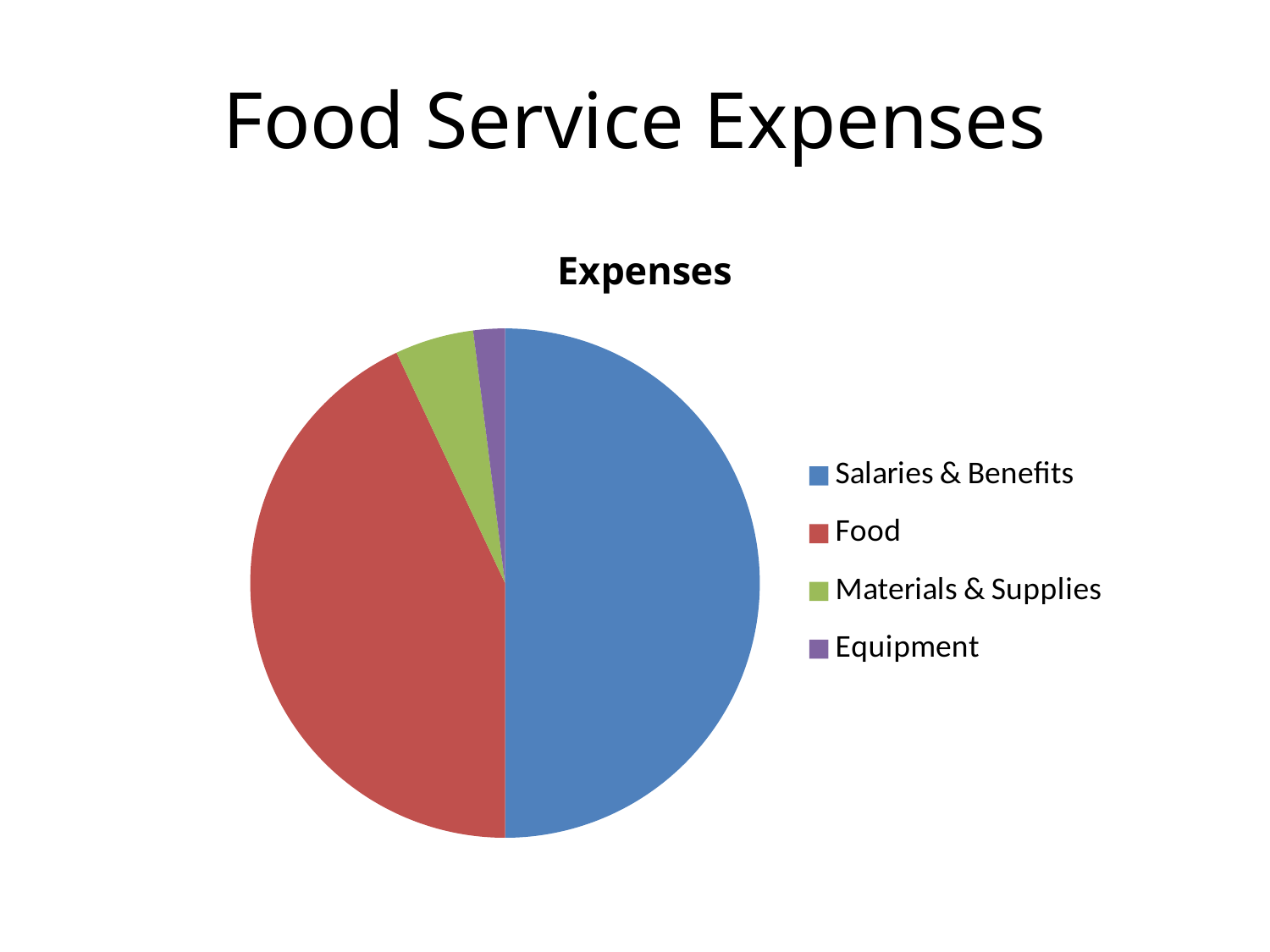
Which slice is larger, Food or Materials & Supplies? Food How many entries does the legend list? 4 Which slice is larger, Materials & Supplies or Equipment? Materials & Supplies Which category has the smallest slice of the pie? Equipment Which slice is larger, Salaries & Benefits or Food? Salaries & Benefits What kind of chart is shown on the slide? Pie chart How many slices does the pie chart have? 4 What is the title of the chart? Expenses What colour is the Food slice in the pie chart? Red Which category has the largest slice of the pie? Salaries & Benefits